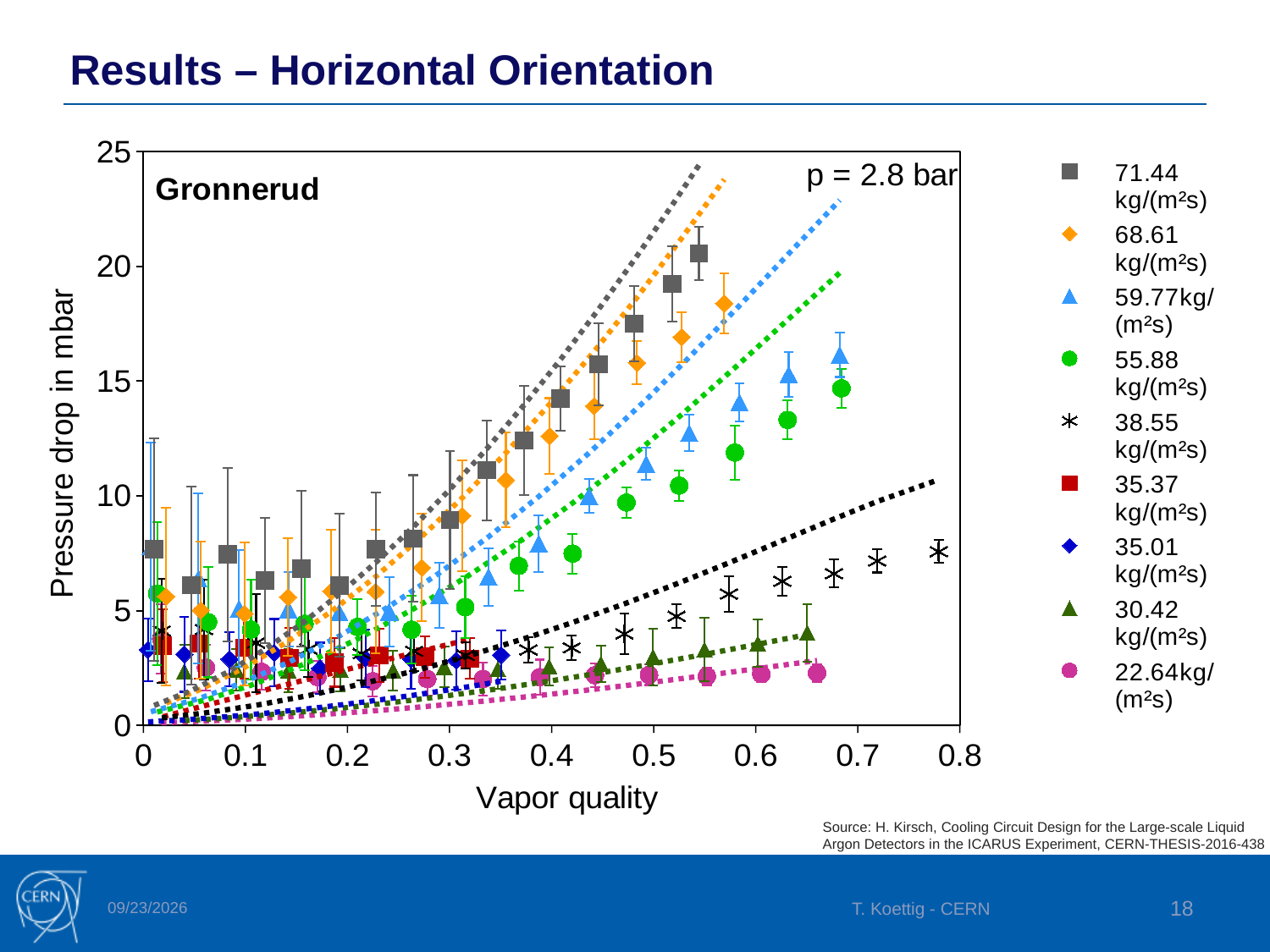
What is the label of the x axis? Vapor quality How many series does the legend list? 9 At a vapor quality of about 0.5, which series has the larger pressure drop: 71.44 kg/(m²s) or 22.64 kg/(m²s)? 71.44 kg/(m²s) Is the highest pressure drop value of the 22.64 kg/(m²s) series greater or less than 5 mbar? less What is the label of the y axis? Pressure drop in mbar Does the pressure drop of the 71.44 kg/(m²s) series rise or fall as vapor quality increases beyond 0.2? rise What is the maximum value shown on the y axis? 25 What kind of chart is shown on the slide? scatter chart Is the pressure drop of the 38.55 kg/(m²s) series at a vapor quality of about 0.78 greater or less than 5 mbar? greater Is the highest pressure drop value of the 71.44 kg/(m²s) series greater or less than 15 mbar? greater Which series reaches the highest pressure drop on the chart? 71.44 kg/(m²s) Which series has the lowest pressure drop values across the chart? 22.64 kg/(m²s)